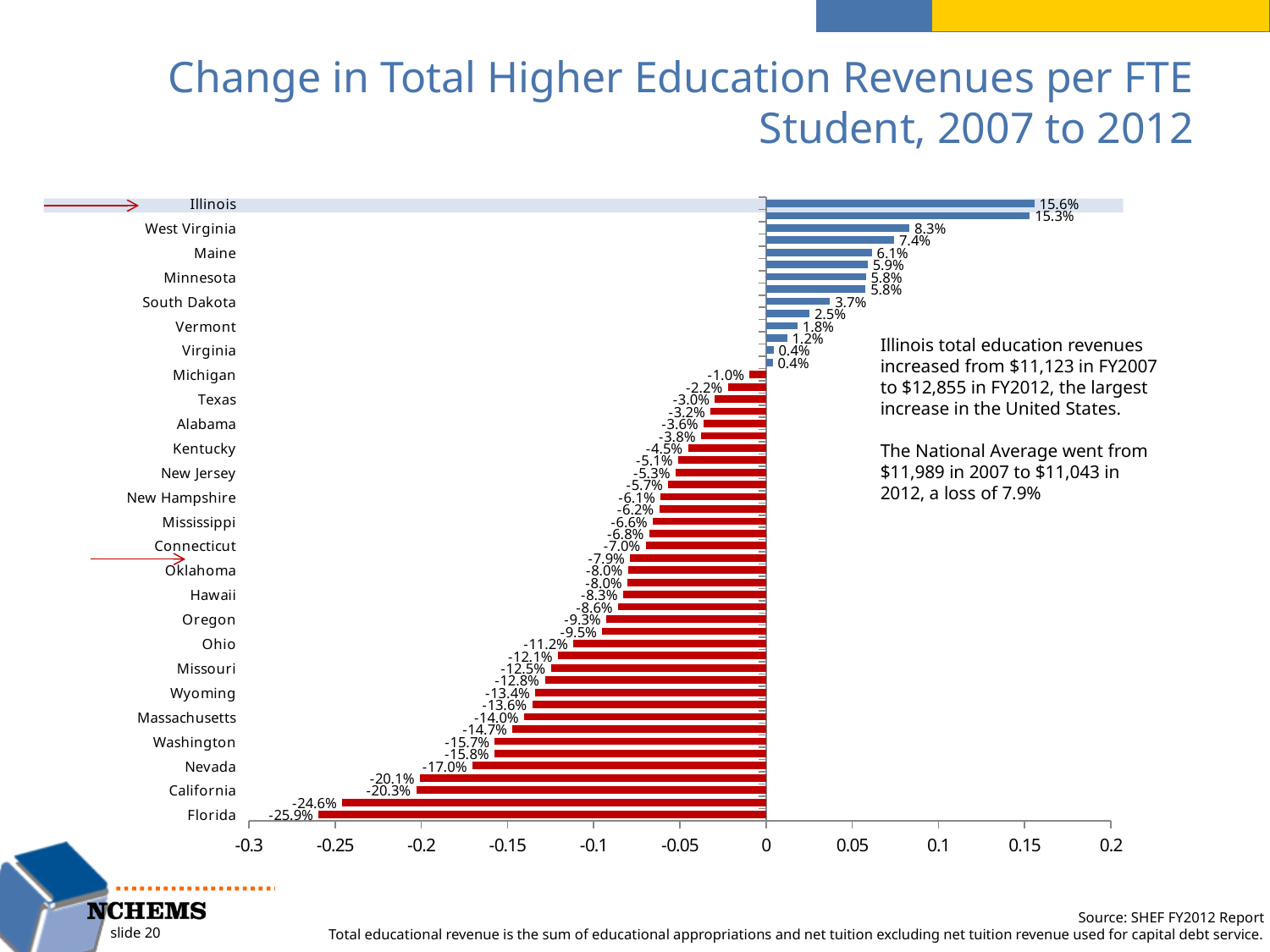
What is the difference between the values for Illinois and West Virginia? 7.3 percentage points Which state has the highest change in total higher education revenues per FTE student? Illinois What is the value shown for Florida? -25.9% What is the value shown for West Virginia? 8.3% What colour are the bars with negative values? Red What kind of chart is shown on the slide? Bar chart Is the value for Ohio greater or less than -0.05? less What is the value shown for California? -20.3% What is the value shown for Illinois? 15.6% Which state has the lowest change in total higher education revenues per FTE student? Florida Which has a larger value, Maine or South Dakota? Maine What is the title of the chart? Change in Total Higher Education Revenues per FTE Student, 2007 to 2012